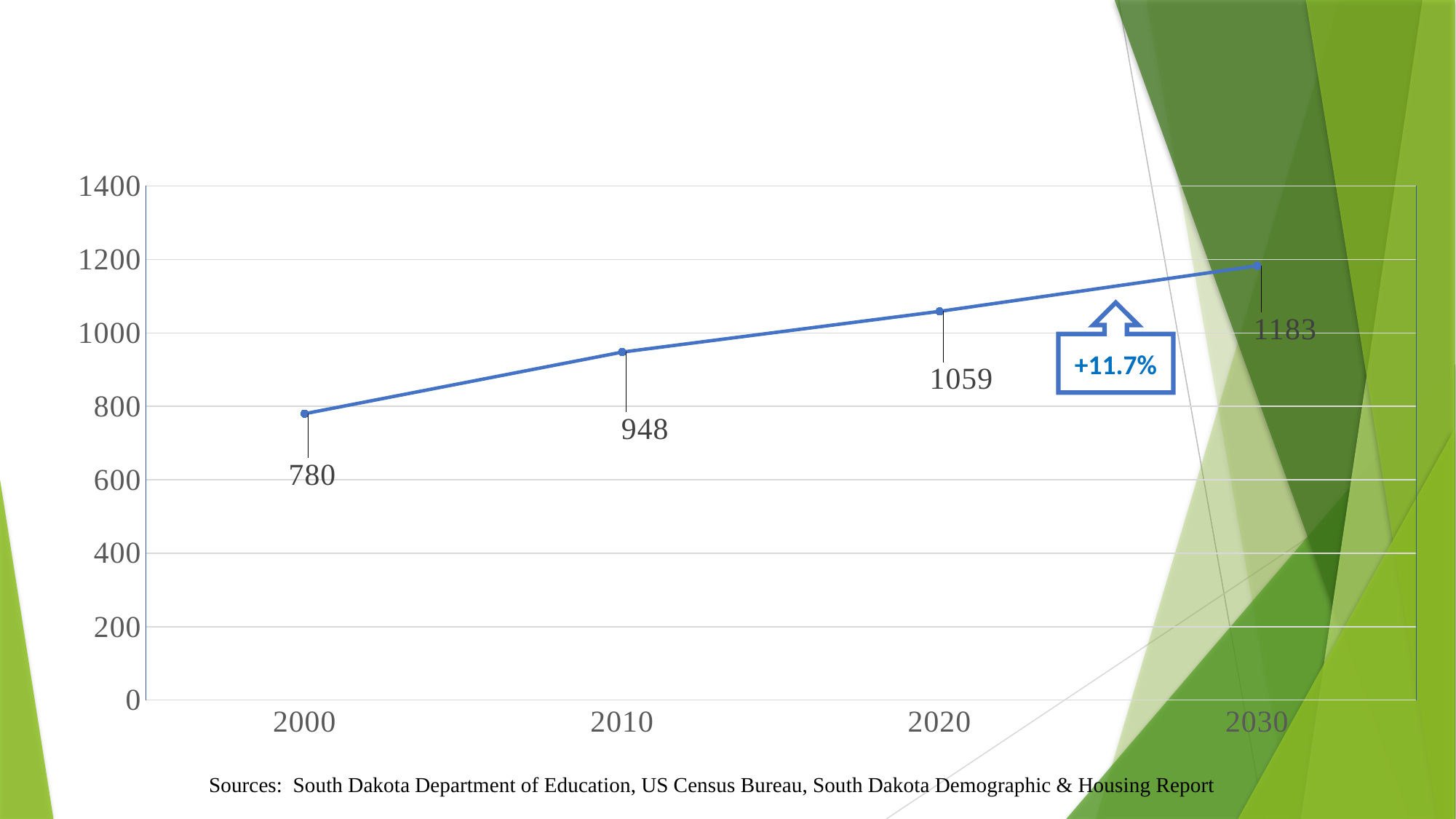
Which year has the highest value? 2030 What is the value for 2020? 1059 What is the difference between the values for 2030 and 2020? 124 Do the values rise or fall from 2000 to 2030? rise What kind of chart is shown on the slide? line chart What is the value for 2010? 948 Which year has the lowest value? 2000 What is the value for 2000? 780 Which is larger, the value for 2010 or the value for 2020? 2020 What is the difference between the values for 2010 and 2000? 168 How many data points are plotted on the chart? 4 What is the value for 2030? 1183